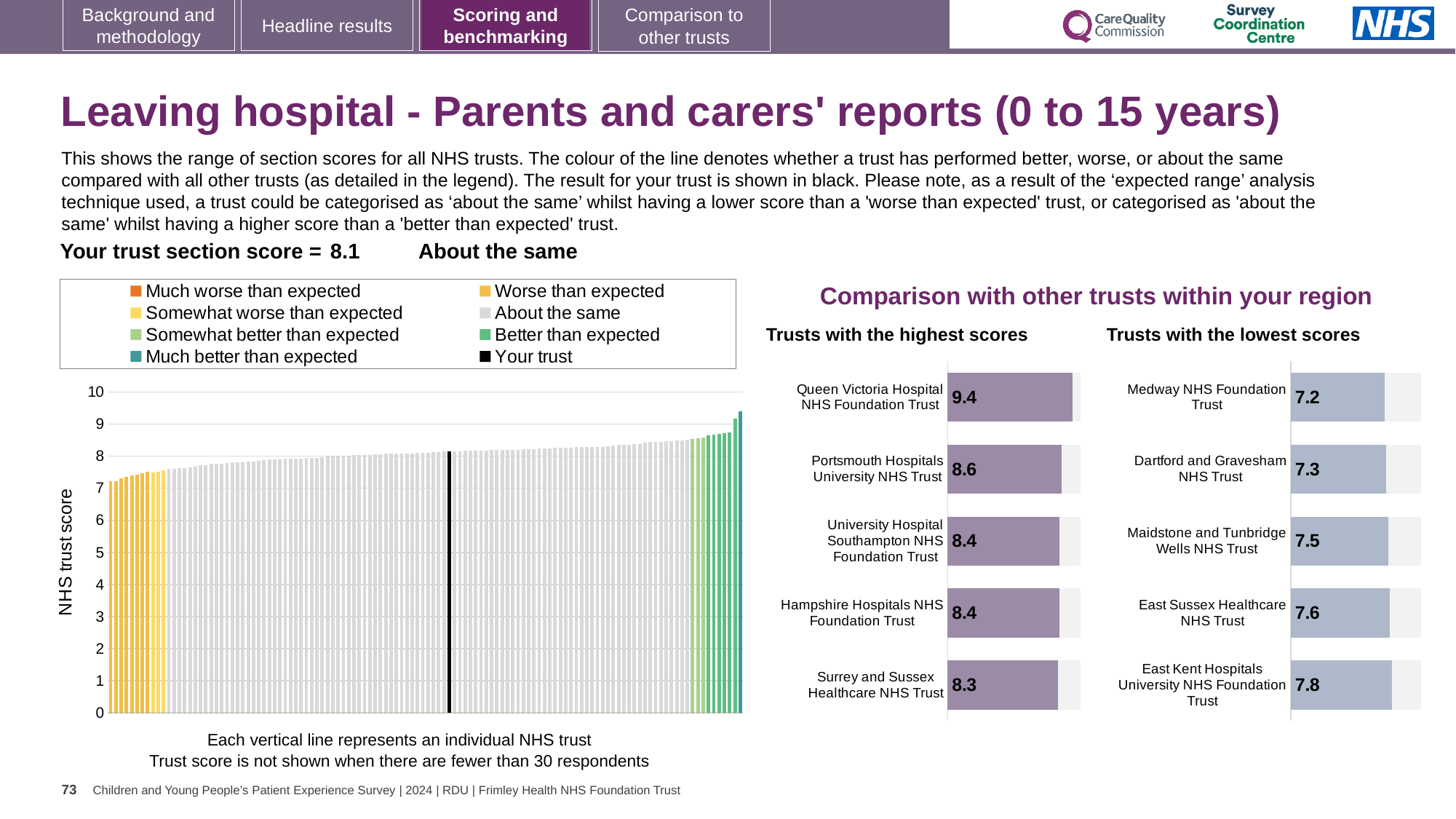
In the 'Trusts with the lowest scores' chart, what is the score for Medway NHS Foundation Trust? 7.2 In the main 'NHS trust score' chart, what is the section score for your trust (the black line)? 8.1 In the main 'NHS trust score' chart, do the trust scores rise or fall from left to right? rise In the 'Trusts with the lowest scores' chart, which trust has the lowest score? Medway NHS Foundation Trust In the 'Trusts with the highest scores' chart, which trust has the highest score? Queen Victoria Hospital NHS Foundation Trust How many trusts are shown in the 'Trusts with the highest scores' chart? 5 How many entries does the legend of the main 'NHS trust score' chart list? 8 In the 'Trusts with the highest scores' chart, what is the score for Queen Victoria Hospital NHS Foundation Trust? 9.4 In the 'Trusts with the highest scores' chart, what is the difference between the scores of Queen Victoria Hospital NHS Foundation Trust and Portsmouth Hospitals University NHS Trust? 0.8 In the main 'NHS trust score' chart, is the value of the tallest bar on the far right greater or less than 9? greater In the 'Trusts with the lowest scores' chart, which has the larger score: East Kent Hospitals University NHS Foundation Trust or Dartford and Gravesham NHS Trust? East Kent Hospitals University NHS Foundation Trust In the 'Trusts with the lowest scores' chart, what is the score for Maidstone and Tunbridge Wells NHS Trust? 7.5